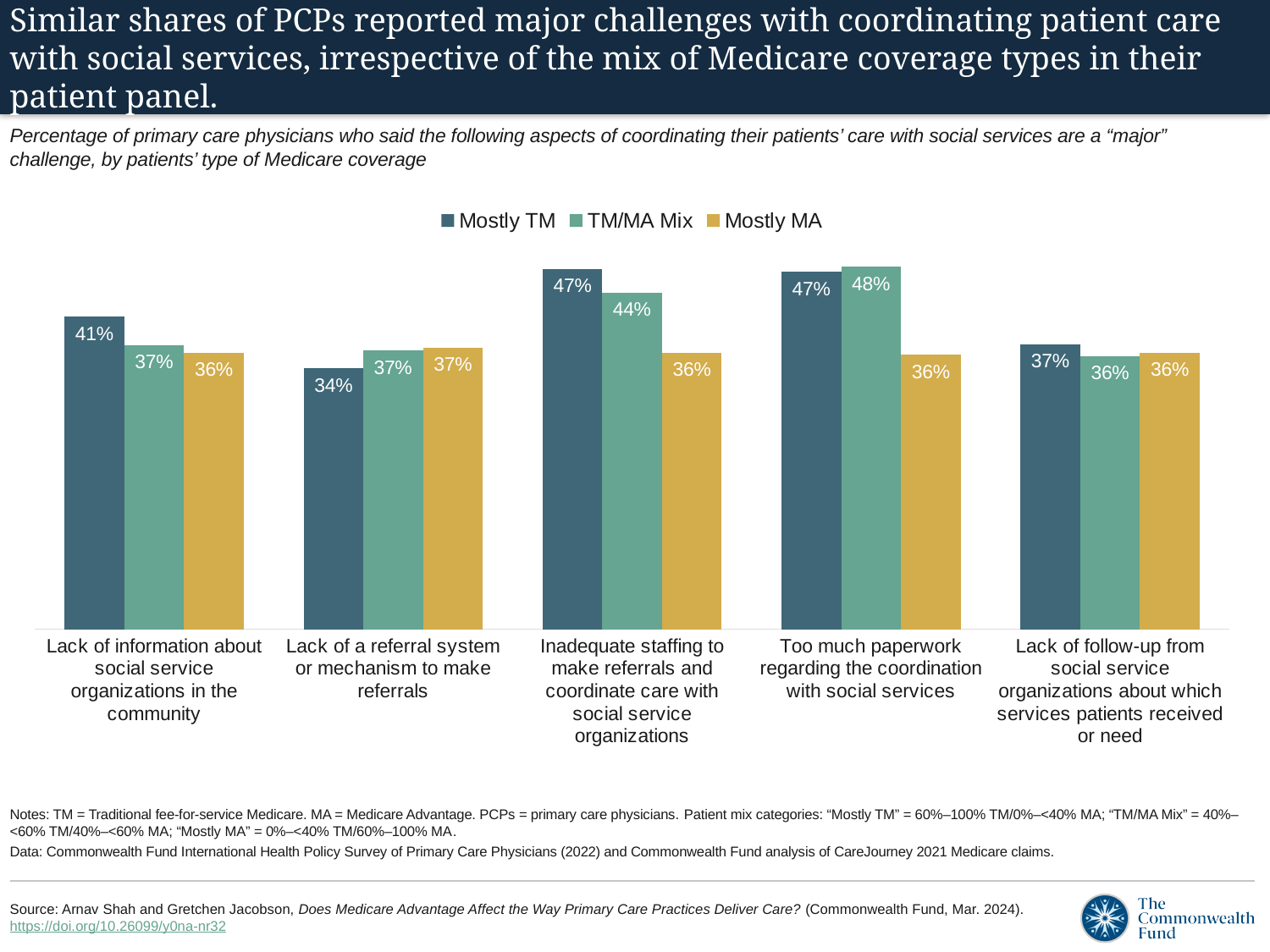
Which series is shown in the gold/yellow colour in the legend? Mostly MA How many categories are shown on the x axis? 5 What is the difference between the Mostly TM and TM/MA Mix values for 'Lack of information about social service organizations in the community'? 4 percentage points What kind of chart is shown on the slide? Bar chart What is the value for Mostly MA for 'Too much paperwork regarding the coordination with social services'? 36% How many series does the legend list? 3 What percentage of Mostly TM physicians said lack of information about social service organizations in the community is a major challenge? 41% Which series has the highest value for 'Too much paperwork regarding the coordination with social services'? TM/MA Mix What is the value for TM/MA Mix for 'Inadequate staffing to make referrals and coordinate care with social service organizations'? 44% Which category has the lowest value for Mostly TM? Lack of a referral system or mechanism to make referrals For 'Lack of a referral system or mechanism to make referrals', which is larger: the Mostly TM value or the Mostly MA value? Mostly MA What is the difference between the Mostly TM and Mostly MA values for 'Inadequate staffing to make referrals and coordinate care with social service organizations'? 11 percentage points